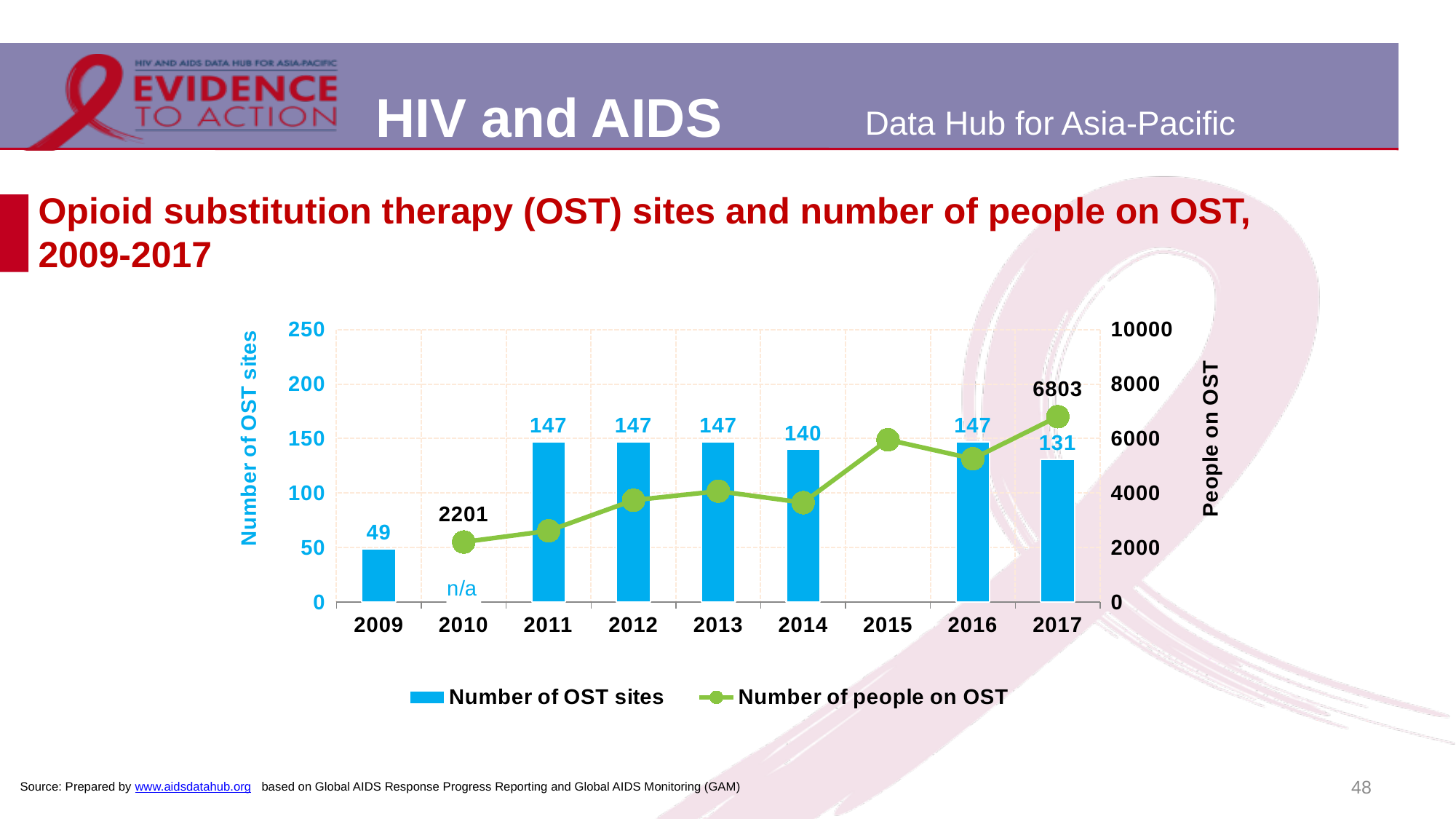
How many series does the legend list? 2 Which year has more OST sites, 2014 or 2017? 2014 What is the number of OST sites in 2017? 131 What is the difference in the number of OST sites between 2011 and 2009? 98 What kind of chart is shown on the slide? Combined bar and line chart Which year has the lowest number of OST sites among the plotted bars? 2009 Is the number of people on OST in 2015 greater or less than 4000? greater By how much did the number of people on OST increase from 2010 to 2017? 4602 What is the number of OST sites in 2014? 140 What is the number of OST sites in 2009? 49 What is the number of people on OST in 2017? 6803 What is the number of people on OST in 2010? 2201